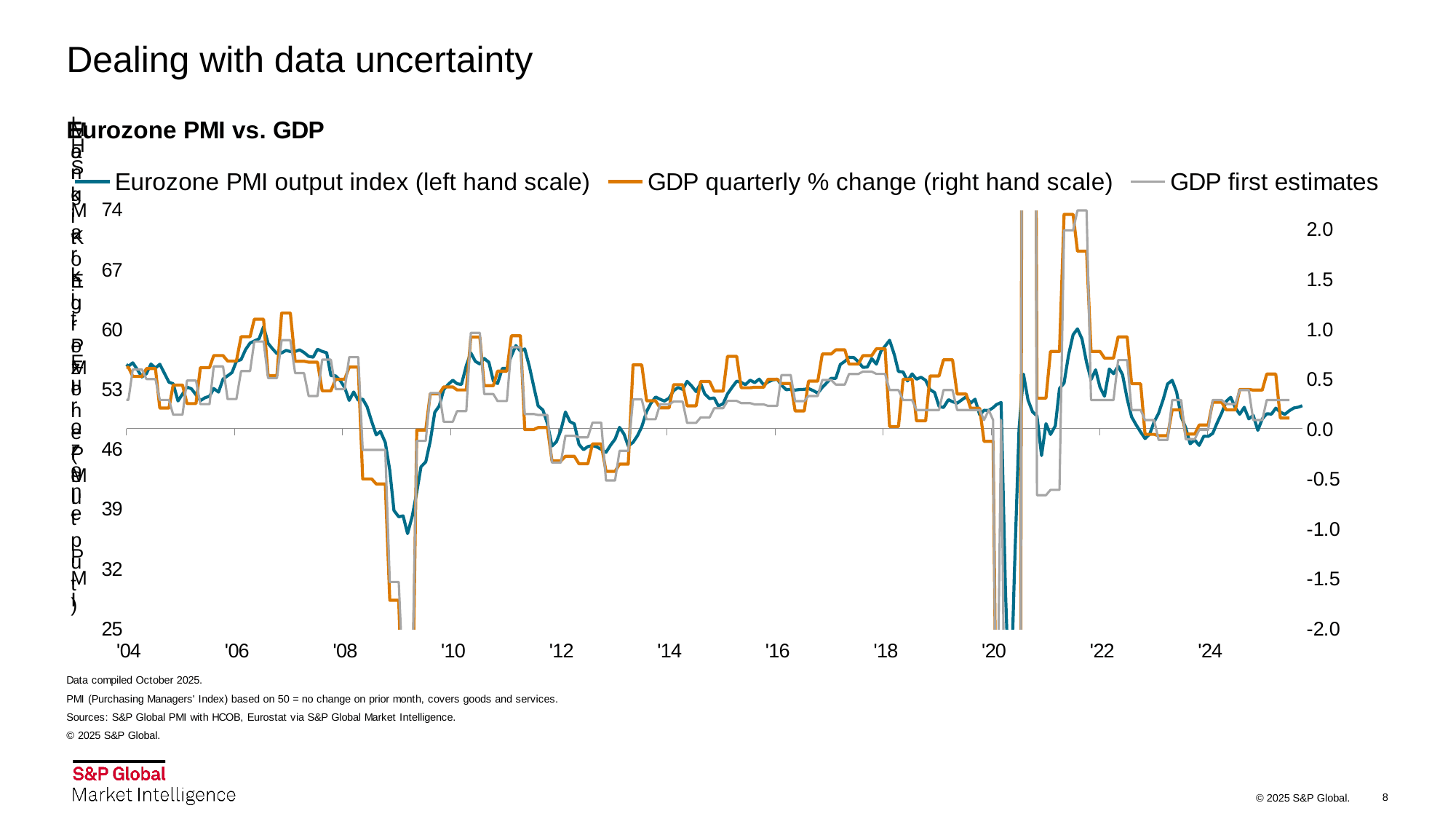
In which year does the Eurozone PMI output index reach its lowest point on the chart? 2020 What kind of chart is shown on the slide? line chart What is the highest tick value shown on the left hand axis? 74 Is the peak of the GDP quarterly % change around 2021 greater or less than 1.5? greater Is the lowest value of the Eurozone PMI output index around 2009 greater or less than 39? less Does the Eurozone PMI output index rise or fall between its 2021 peak and 2023? fall What is the title of the chart? Eurozone PMI vs. GDP How many year labels are shown on the x axis? 11 Is the Eurozone PMI output index at the start of '04 greater or less than 53? greater How many series does the legend list? 3 Which series is plotted on the right hand scale according to the legend? GDP quarterly % change